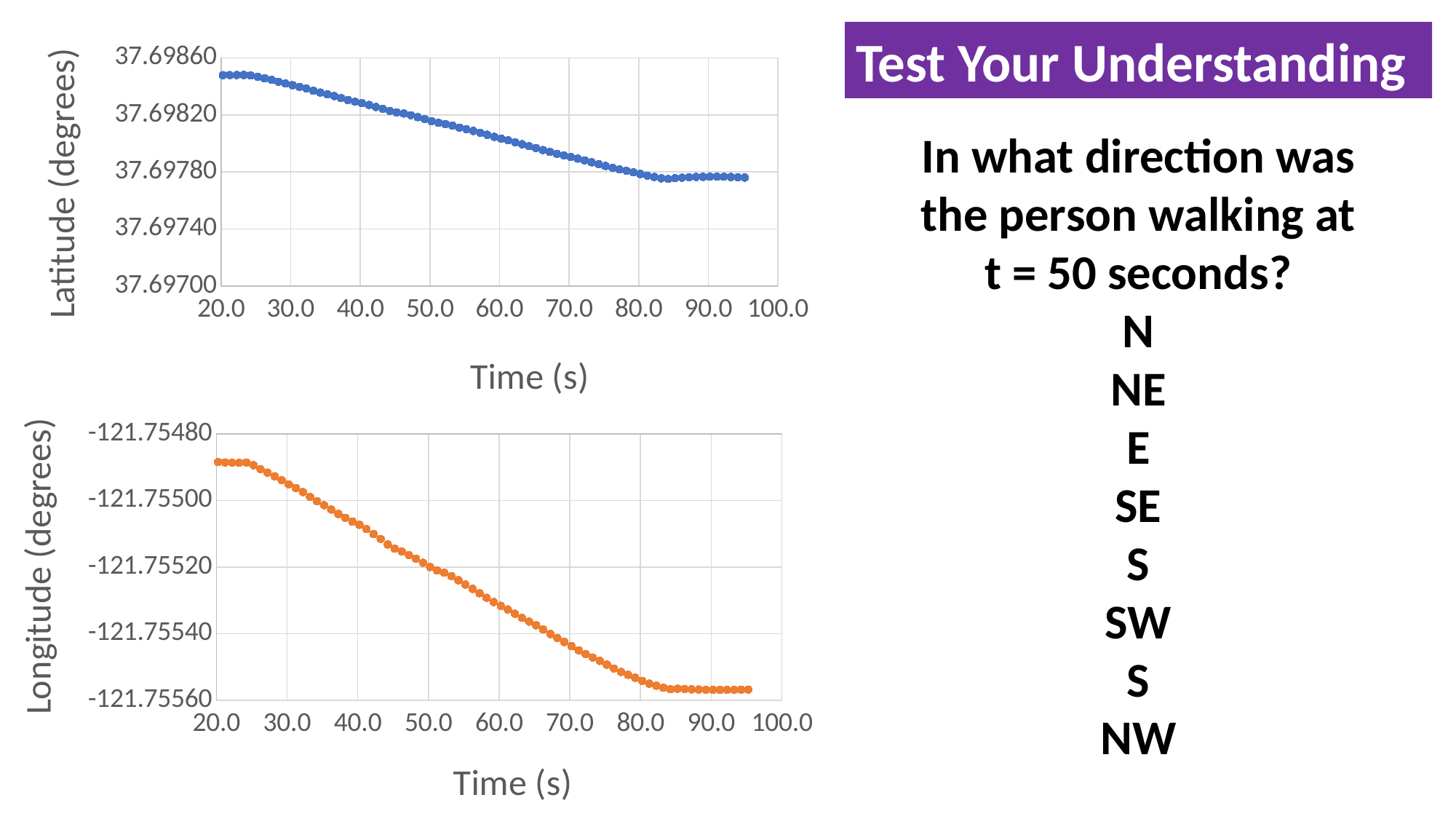
In the bottom chart, is the longitude at t = 30 s greater or less than -121.75500? greater What colour are the data points in the bottom chart (Longitude vs Time)? orange What kind of chart is the bottom chart (Longitude vs Time)? scatter chart In the top chart, is the latitude at t = 70 s greater or less than 37.69820? less What is the x-axis title of the bottom chart? Time (s) In the top chart, does the latitude rise or fall as time increases from 20 s to 80 s? fall In the bottom chart, does the longitude rise or fall as time increases from 20 s to 80 s? fall In the top chart, is the latitude at t = 30 s greater or less than 37.69820? greater What kind of chart is the top chart (Latitude vs Time)? scatter chart